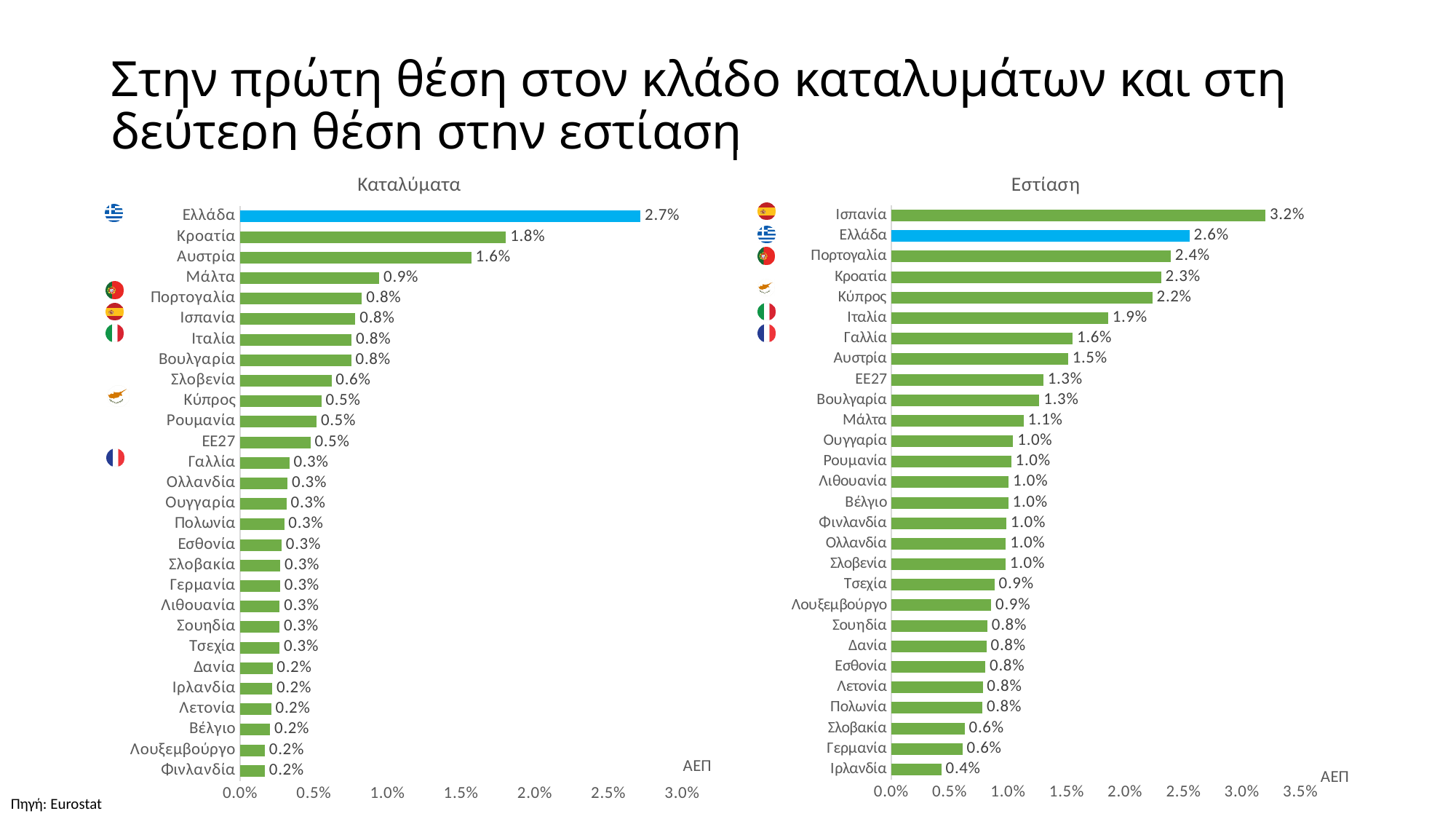
In the Εστίαση chart, which is larger, Πορτογαλία or Ιταλία? Πορτογαλία What type of chart is the Καταλύματα chart? Bar chart In the Καταλύματα chart, what is the value for ΕΕ27? 0.5% In the Καταλύματα chart, what is the value for Ελλάδα? 2.7% In the Εστίαση chart, what is the value for Κύπρος? 2.2% In the Εστίαση chart, what is the value for Ισπανία? 3.2% In the Εστίαση chart, what is the value for Ελλάδα? 2.6% In the Εστίαση chart, which country has the lowest value? Ιρλανδία In the Καταλύματα chart, what is the difference between Ελλάδα and Κροατία? 0.9% In the Εστίαση chart, what is the difference between Ισπανία and Ελλάδα? 0.6% How many countries/categories are shown in the Εστίαση chart? 28 In the Καταλύματα chart, which country has the highest value? Ελλάδα